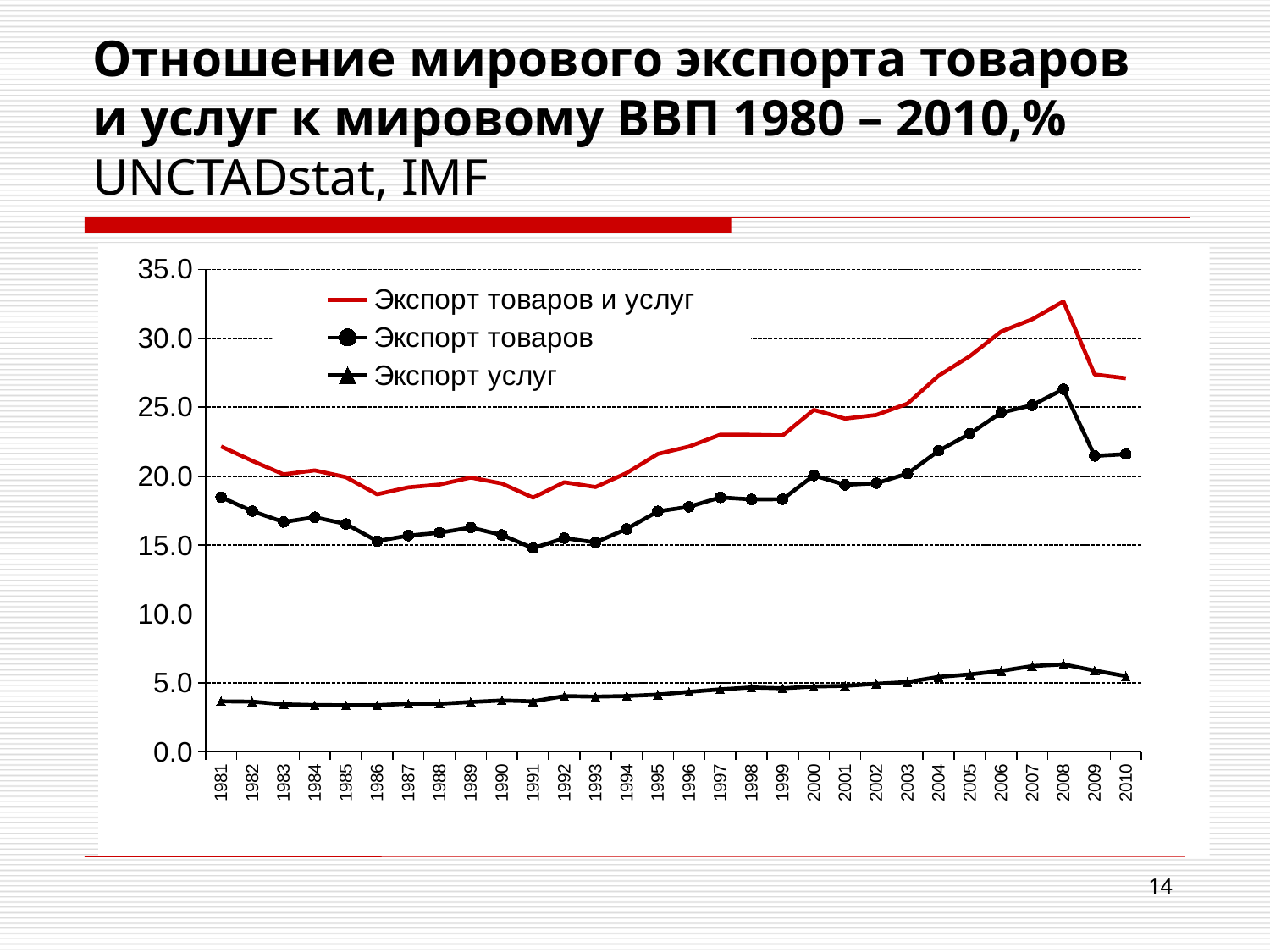
Which series is drawn in red? Экспорт товаров и услуг Is the value for 'Экспорт товаров и услуг' in 2008 greater or less than 30.0? greater Does the series 'Экспорт услуг' generally rise or fall from 1991 to 2008? rise What kind of chart is shown on the slide? line chart How many series does the legend list? 3 Is the value for 'Экспорт услуг' in 2008 greater or less than 5.0? greater How many years are plotted along the x axis? 30 Which series is larger in 2010, 'Экспорт товаров' or 'Экспорт услуг'? Экспорт товаров In which year does the series 'Экспорт товаров' reach its lowest value? 1991 Does the series 'Экспорт товаров и услуг' rise or fall between 2008 and 2009? fall In which year does the series 'Экспорт товаров и услуг' reach its highest value? 2008